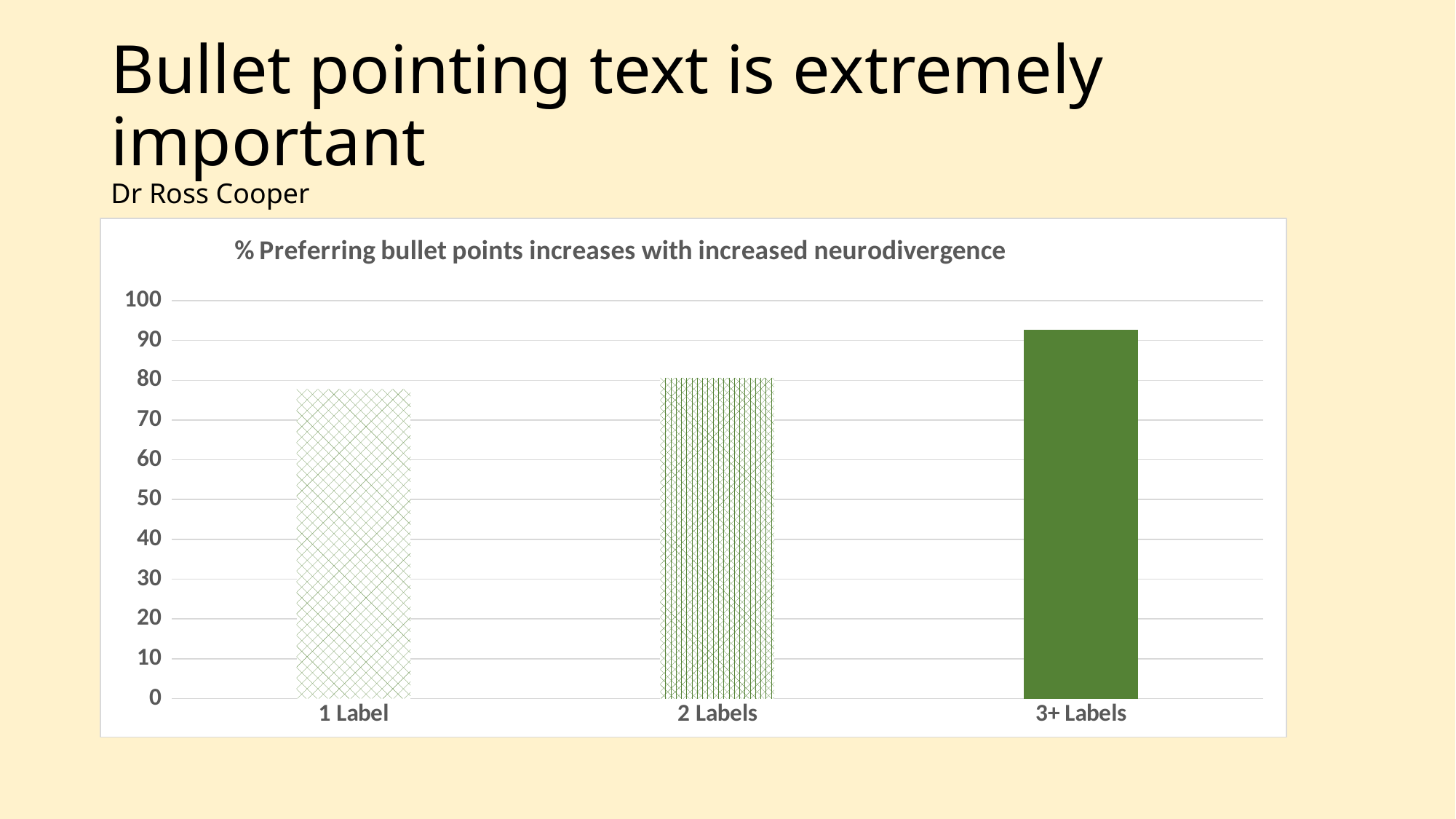
Do the values rise or fall from 1 Label to 3+ Labels along the x axis? rise What is the title of the chart? % Preferring bullet points increases with increased neurodivergence Is the value for 2 Labels greater or less than 70? greater Which is larger, the value for 1 Label or the value for 3+ Labels? 3+ Labels Is the value for 1 Label greater or less than 80? less Is the value for 3+ Labels greater or less than 90? greater Which is larger, the value for 1 Label or the value for 2 Labels? 2 Labels How many categories are shown on the x axis of the chart? 3 What kind of chart is shown on the slide? bar chart Which category has the lowest value? 1 Label Which category has the highest value? 3+ Labels